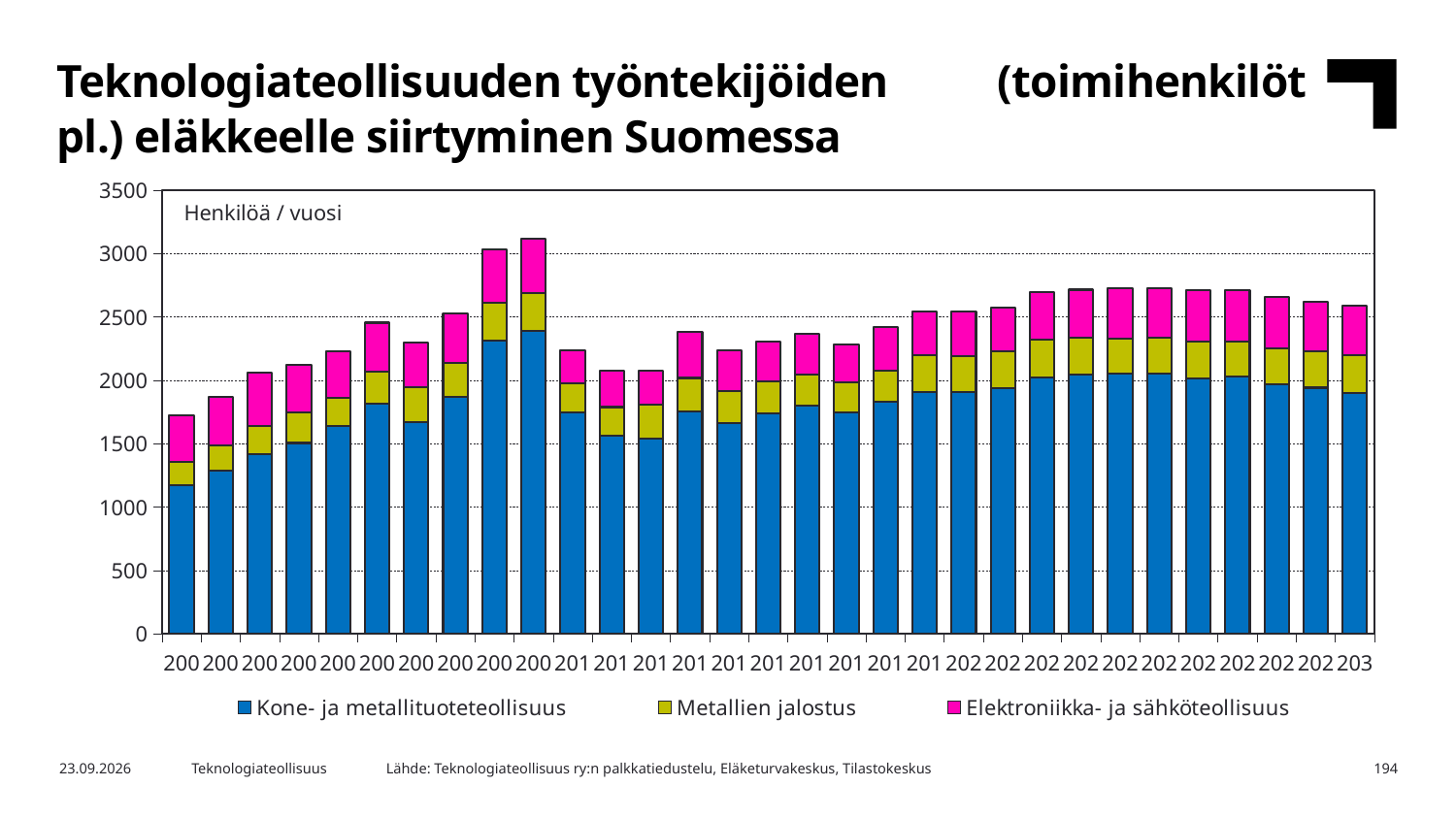
What kind of chart is shown on the slide? stacked bar chart Which series forms the bottom segment of each stacked bar? Kone- ja metallituoteteollisuus What unit label is printed inside the plot area at the top left? Henkilöä / vuosi Is the total of the first (leftmost) bar greater or less than 2000? less Is the total of the tallest bar greater or less than 3000? greater How many bars are plotted in the chart? 31 How many series does the legend list? 3 Is the total of the last (rightmost) bar greater or less than 3000? less Which bar has the larger total, the first (leftmost) bar or the last (rightmost) bar? the last (rightmost) bar Which series is shown in blue in the legend? Kone- ja metallituoteteollisuus